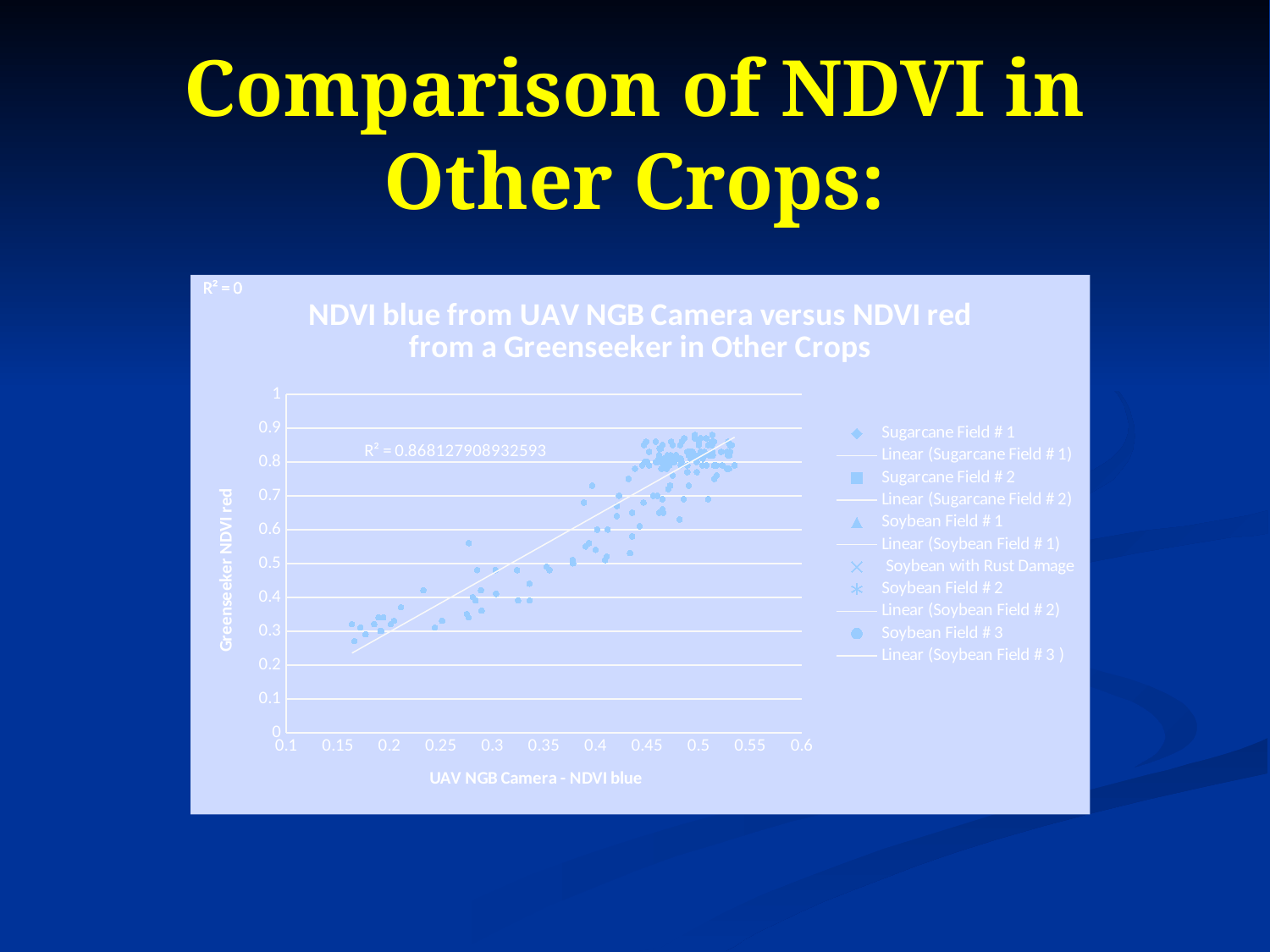
What is the label of the x axis? UAV NGB Camera - NDVI blue What kind of chart is shown on the slide? Scatter chart What is the title of the chart? NDVI blue from UAV NGB Camera versus NDVI red from a Greenseeker in Other Crops What is the maximum value shown on the x axis of the chart? 0.6 What is the maximum value shown on the y axis of the chart? 1 Do the Greenseeker NDVI red values rise or fall as UAV NGB Camera NDVI blue increases along the x axis? Rise How many entries does the chart legend list? 11 Are the highest points on the chart greater or less than 0.8 on the y axis? greater What is the minimum value shown on the x axis of the chart? 0.1 Are the points plotted near 0.15 on the x axis greater or less than 0.4 on the y axis? less What is the R² value printed inside the plot area of the chart? R² = 0.868127908932593